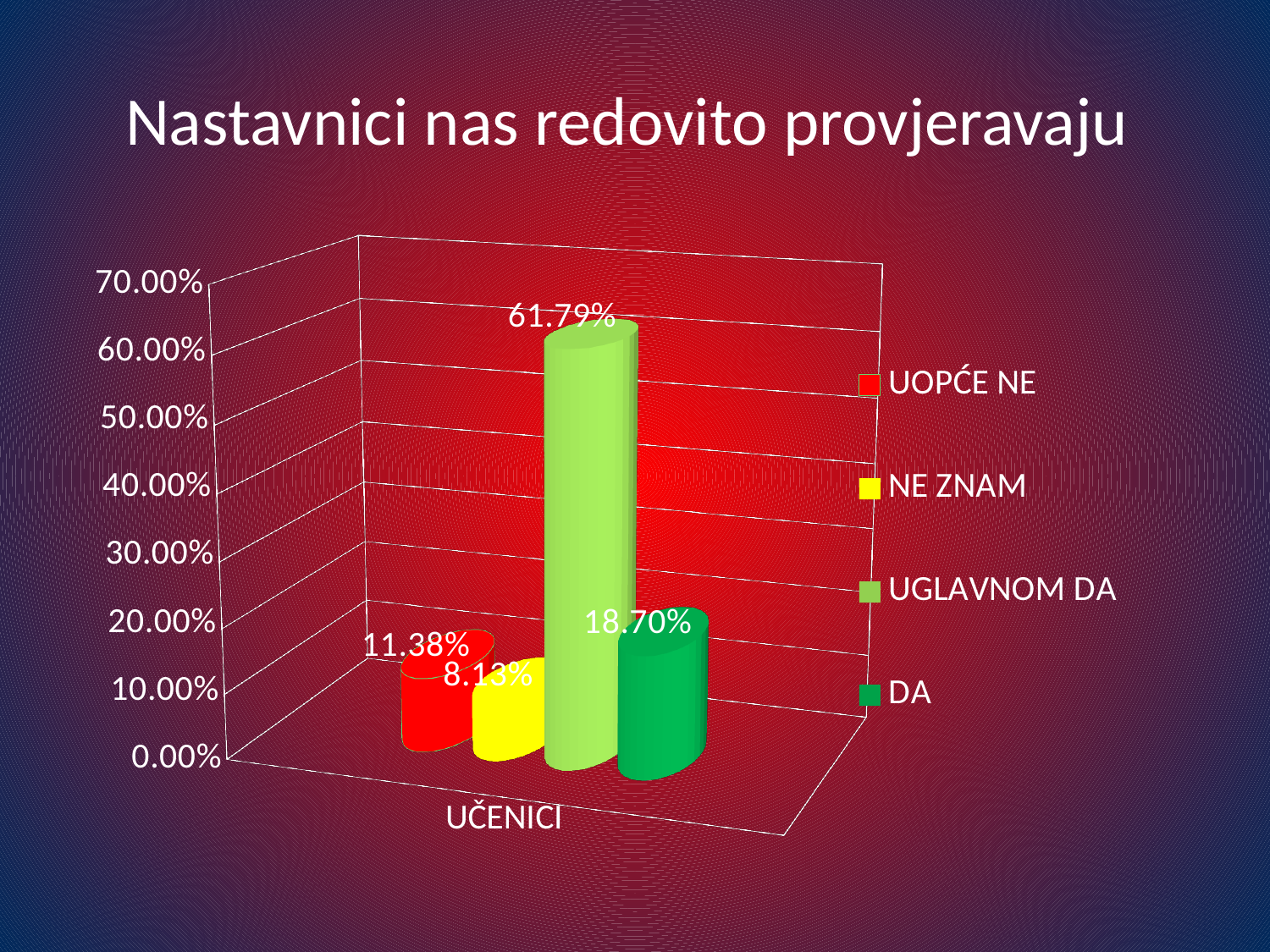
What is the title of the chart? Nastavnici nas redovito provjeravaju What is the value for UOPĆE NE? 11.38% How many series does the legend list? 4 What kind of chart is shown on the slide? Bar chart Which is larger, the value for DA or the value for UOPĆE NE? DA What is the difference between the values for UOPĆE NE and NE ZNAM? 3.25% Which series has the highest value? UGLAVNOM DA What is the value for DA? 18.70% Which series has the lowest value? NE ZNAM What is the difference between the values for UGLAVNOM DA and DA? 43.09% What is the value for UGLAVNOM DA? 61.79% What is the value for NE ZNAM? 8.13%